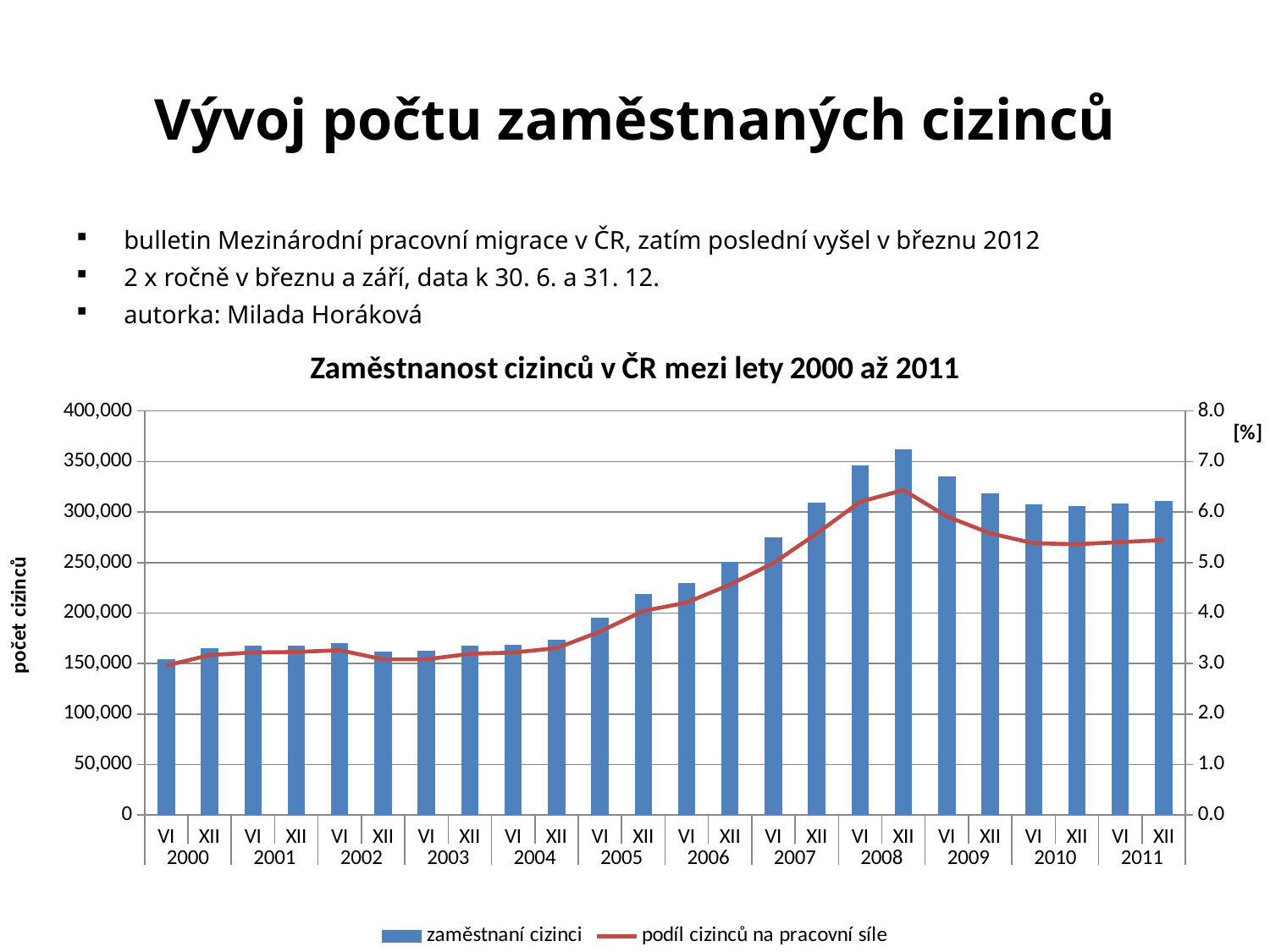
Is the number of employed foreigners in VI 2009 greater or less than 350,000? less Is the number of employed foreigners in VI 2007 greater or less than 250,000? greater What is the title of the chart? Zaměstnanost cizinců v ČR mezi lety 2000 až 2011 How many series does the chart legend list? 2 In which period is the number of employed foreigners (zaměstnaní cizinci) highest? XII 2008 What kind of chart is shown on the slide? combined bar and line chart Is the share of foreigners in the labour force (podíl cizinců na pracovní síle) in XII 2008 greater or less than 6.0%? greater Which is larger, the number of employed foreigners in XII 2008 or in VI 2009? XII 2008 In which period is the number of employed foreigners (zaměstnaní cizinci) lowest? VI 2000 Do the bars for employed foreigners rise or fall from VI 2004 to XII 2008? rise How many bars are plotted in the chart? 24